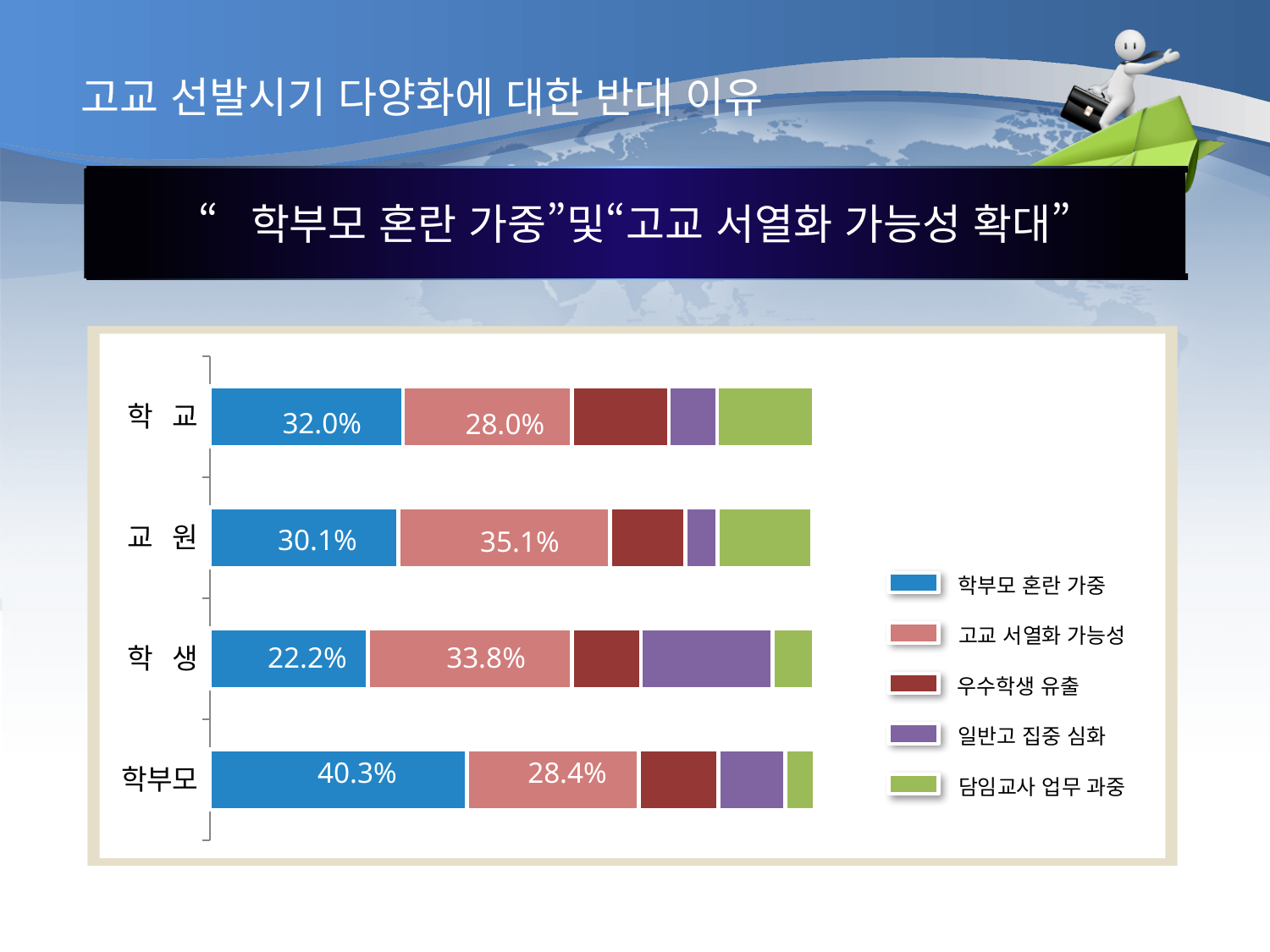
What is the value of 고교 서열화 가능성 for 학교? 28.0% What is the value of 학부모 혼란 가중 for 학부모? 40.3% Which category has the highest value for 학부모 혼란 가중? 학부모 What is the difference between the 학부모 혼란 가중 values for 학부모 and 학생? 18.1% Which category has the lowest value for 학부모 혼란 가중? 학생 How many series does the legend list? 5 What kind of chart is shown on the slide? stacked bar chart Which category has the highest value for 고교 서열화 가능성? 교원 What is the value of 학부모 혼란 가중 for 학생? 22.2% What is the value of 고교 서열화 가능성 for 교원? 35.1% For 교원, which is larger: 학부모 혼란 가중 or 고교 서열화 가능성? 고교 서열화 가능성 How many categories are plotted on the chart? 4